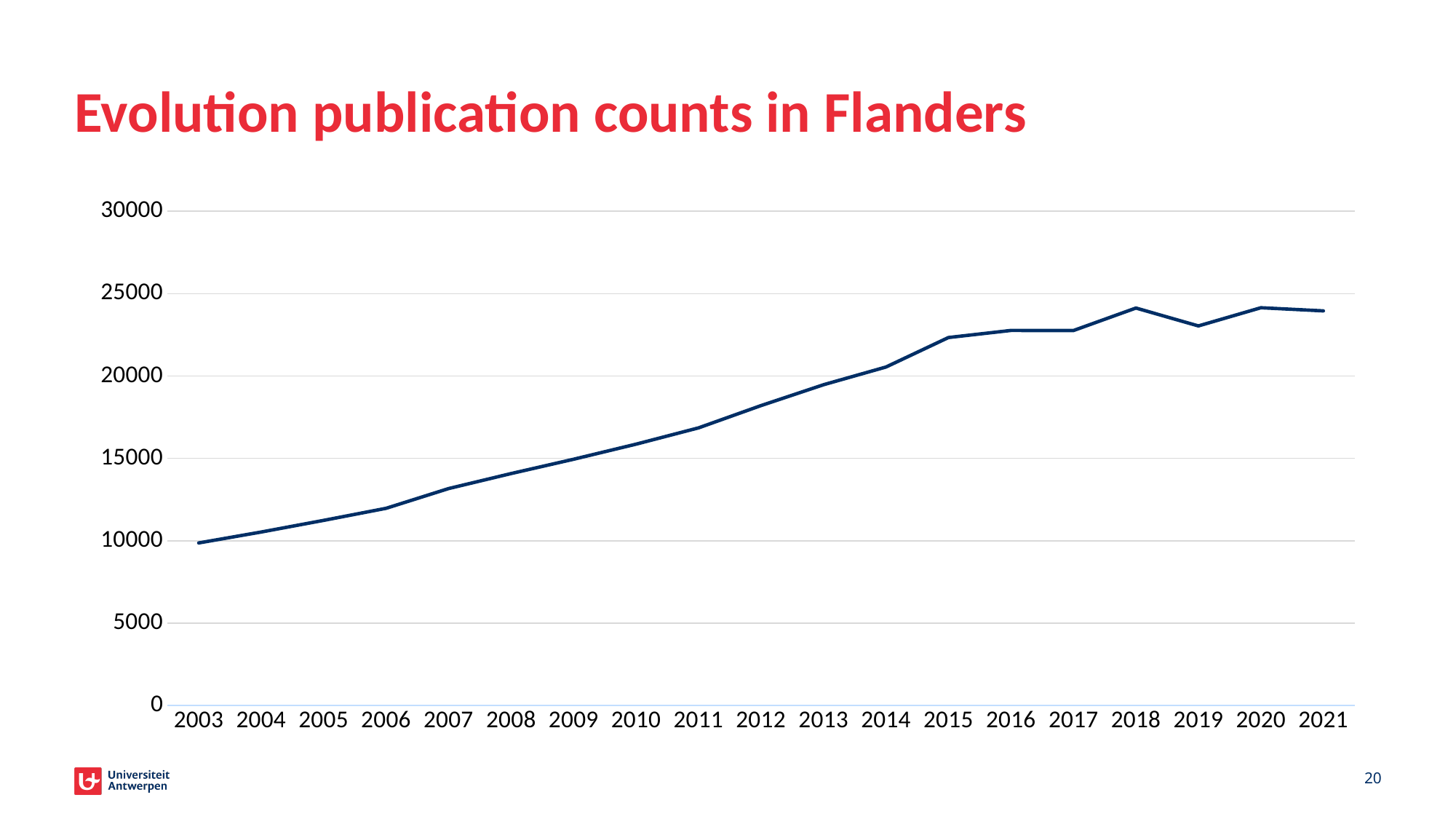
Is the value for 2011 greater or less than 15000? greater Do the publication counts generally rise or fall from 2003 to 2021? rise Is the value for 2008 greater or less than 15000? less How many years are plotted along the x axis? 19 Which year has the higher publication count, 2010 or 2015? 2015 Which year has the lowest publication count? 2003 Which year has the higher publication count, 2018 or 2019? 2018 What kind of chart is shown on the slide? line chart What is the title of the slide's chart? Evolution publication counts in Flanders Is the value for 2003 greater or less than 15000? less